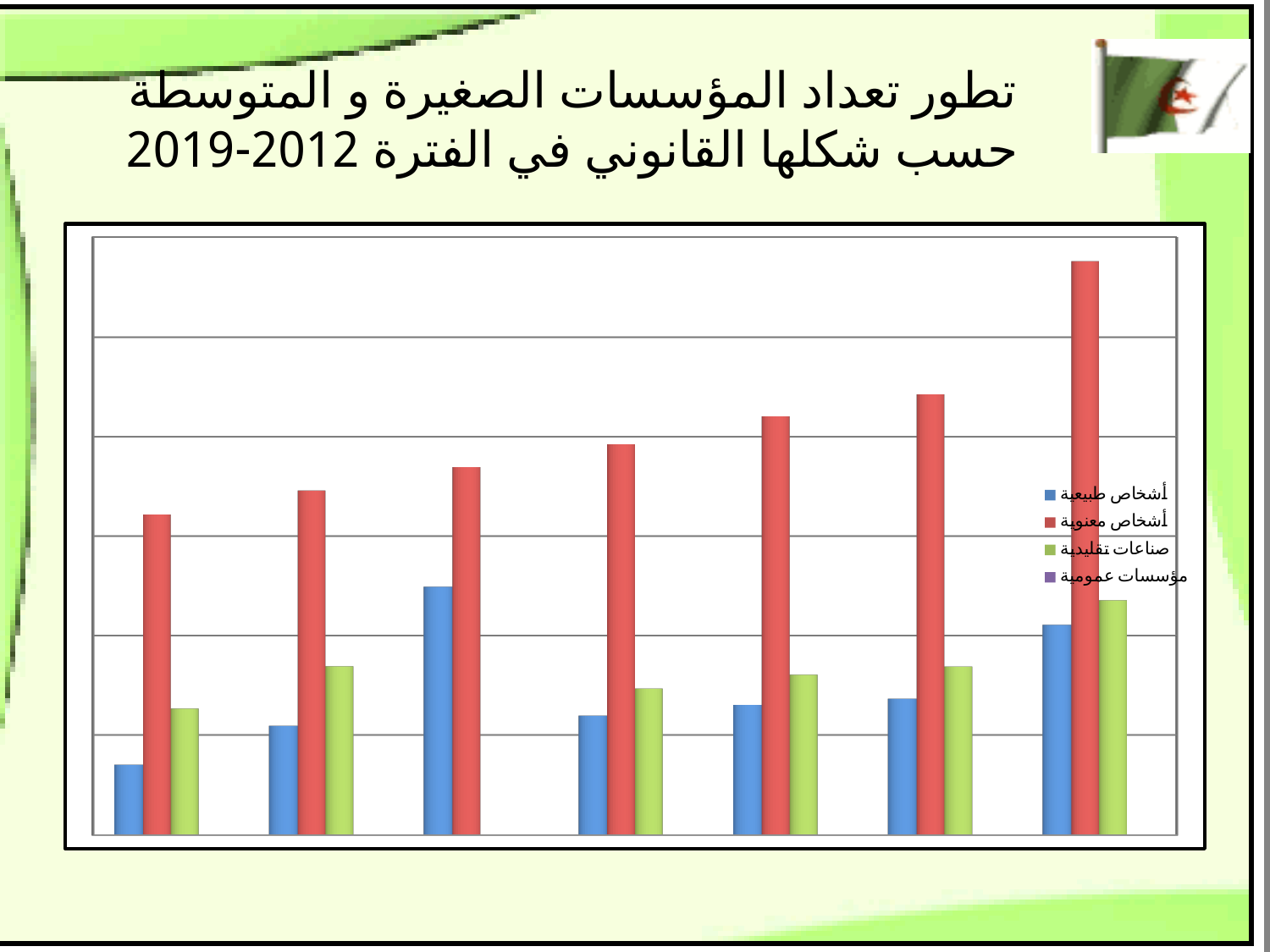
Do the values for أشخاص معنوية rise or fall from left to right along the x axis? rise How many series does the legend list? 4 Which series is shown in red in the legend? أشخاص معنوية In the leftmost group, which is larger: the bar for أشخاص طبيعية or the bar for صناعات تقليدية? صناعات تقليدية In the rightmost group, which is larger: the bar for أشخاص معنوية or the bar for صناعات تقليدية? أشخاص معنوية In which group is the bar for أشخاص طبيعية the lowest? the leftmost group What kind of chart is shown on the slide? bar chart Which series is shown in blue in the legend? أشخاص طبيعية Which series has the tallest bar in every group? أشخاص معنوية How many groups of bars are plotted along the x axis? 7 In which group is the bar for أشخاص معنوية the highest? the rightmost group